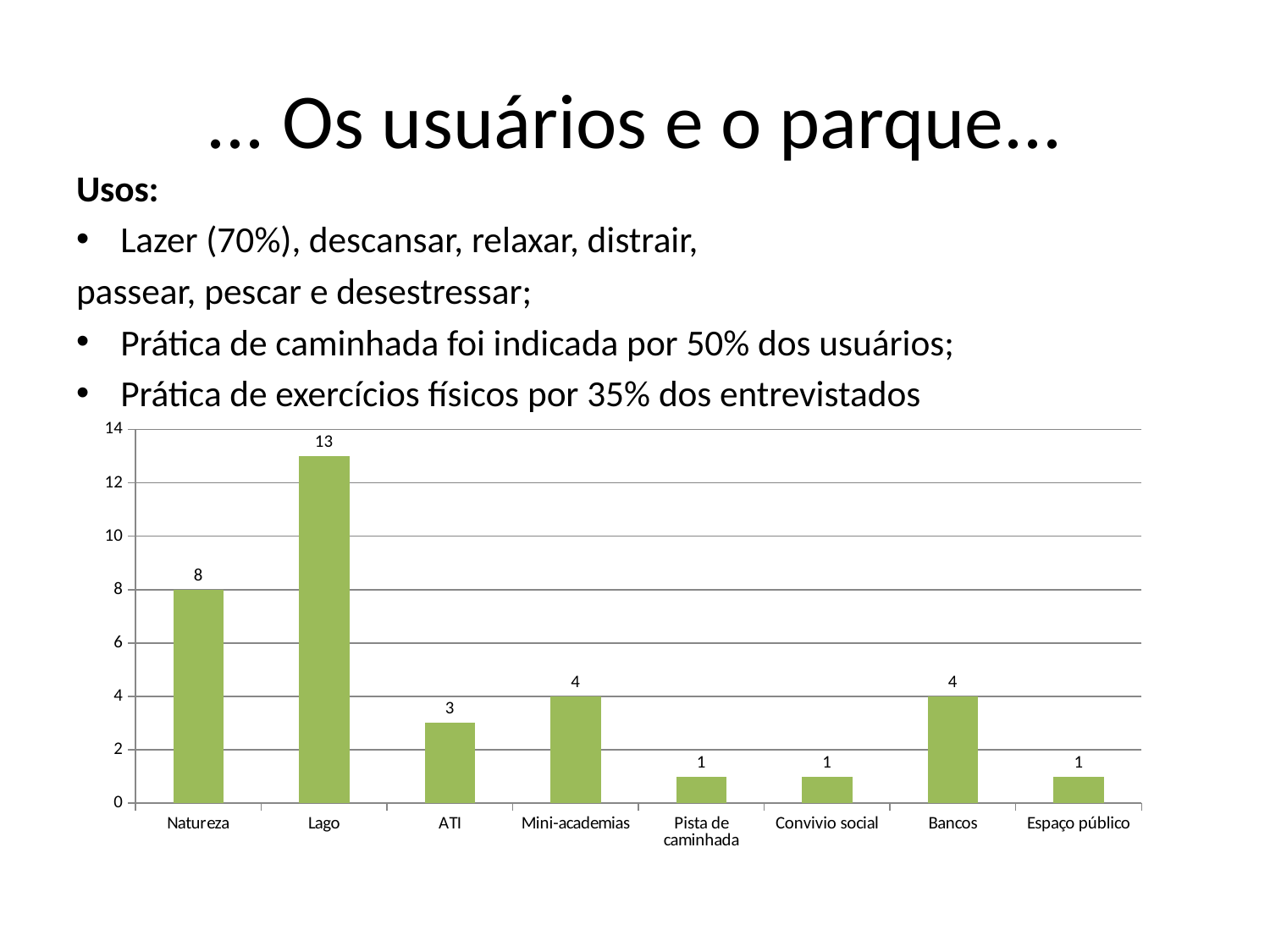
Which is larger, the value for Mini-academias or the value for ATI? Mini-academias What colour are the bars in the chart? green What is the difference between the values for Lago and Natureza? 5 Which category has the highest value? Lago What is the value for Bancos? 4 What kind of chart is shown on the slide? bar chart Is the value for Natureza greater or less than 6? greater How many categories are shown on the x axis? 8 What is the value for ATI? 3 How many categories have a value of 1? 3 What is the value for Natureza? 8 What is the value for Lago? 13